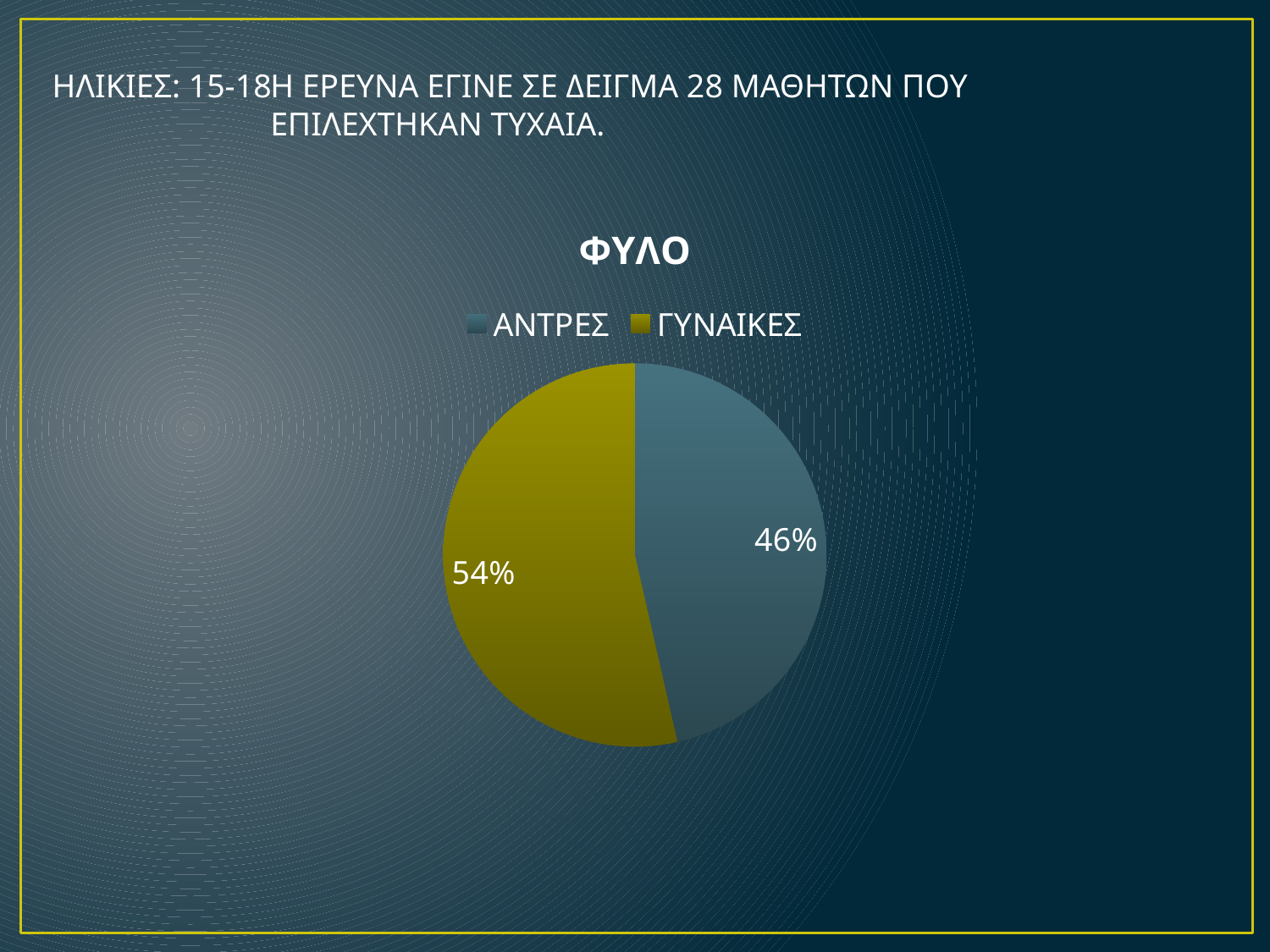
Which category has the largest slice of the pie? ΓΥΝΑΙΚΕΣ Which is larger, the share for ΑΝΤΡΕΣ or the share for ΓΥΝΑΙΚΕΣ? ΓΥΝΑΙΚΕΣ Which category has the smallest slice of the pie? ΑΝΤΡΕΣ What share of the pie does ΑΝΤΡΕΣ represent? 46% What kind of chart is shown on the slide? pie chart What is the title of the chart? ΦΥΛΟ What is the difference in percentage points between ΓΥΝΑΙΚΕΣ and ΑΝΤΡΕΣ? 8% Is the share for ΑΝΤΡΕΣ greater or less than 50%? less Which colour represents ΓΥΝΑΙΚΕΣ in the pie chart? yellow How many slices does the pie chart have? 2 What share of the pie does ΓΥΝΑΙΚΕΣ represent? 54% How many entries does the legend list? 2